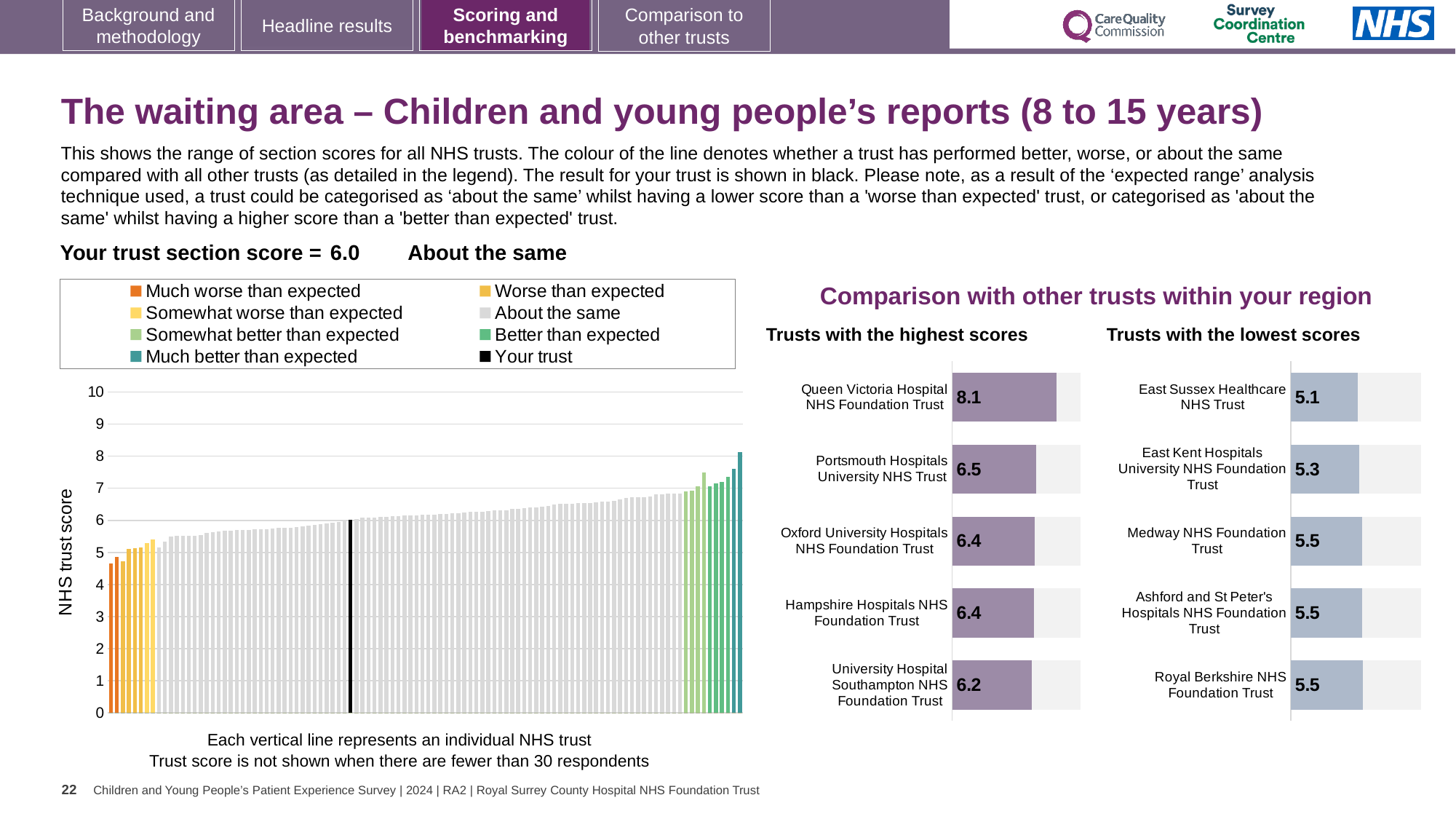
In the main chart on the left showing all NHS trusts, is the value of the lowest bar greater or less than 5? less In the 'Trusts with the highest scores' chart, what is the score for Queen Victoria Hospital NHS Foundation Trust? 8.1 In the 'Trusts with the lowest scores' chart, which is larger: the score for East Kent Hospitals University NHS Foundation Trust or East Sussex Healthcare NHS Trust? East Kent Hospitals University NHS Foundation Trust In the 'Trusts with the highest scores' chart, what is the difference between the scores of Queen Victoria Hospital NHS Foundation Trust and University Hospital Southampton NHS Foundation Trust? 1.9 In the 'Trusts with the highest scores' chart, what is the score for University Hospital Southampton NHS Foundation Trust? 6.2 In the 'Trusts with the highest scores' chart, which trust has the highest score? Queen Victoria Hospital NHS Foundation Trust In the main chart on the left showing all NHS trusts, what is the section score for your trust? 6.0 In the main chart on the left showing all NHS trusts, how many entries does the legend list? 8 In the 'Trusts with the lowest scores' chart, what is the difference between the scores of Medway NHS Foundation Trust and East Sussex Healthcare NHS Trust? 0.4 In the 'Trusts with the lowest scores' chart, what is the score for East Kent Hospitals University NHS Foundation Trust? 5.3 In the 'Trusts with the lowest scores' chart, which trust has the lowest score? East Sussex Healthcare NHS Trust In the 'Trusts with the highest scores' chart, how many trusts are shown? 5